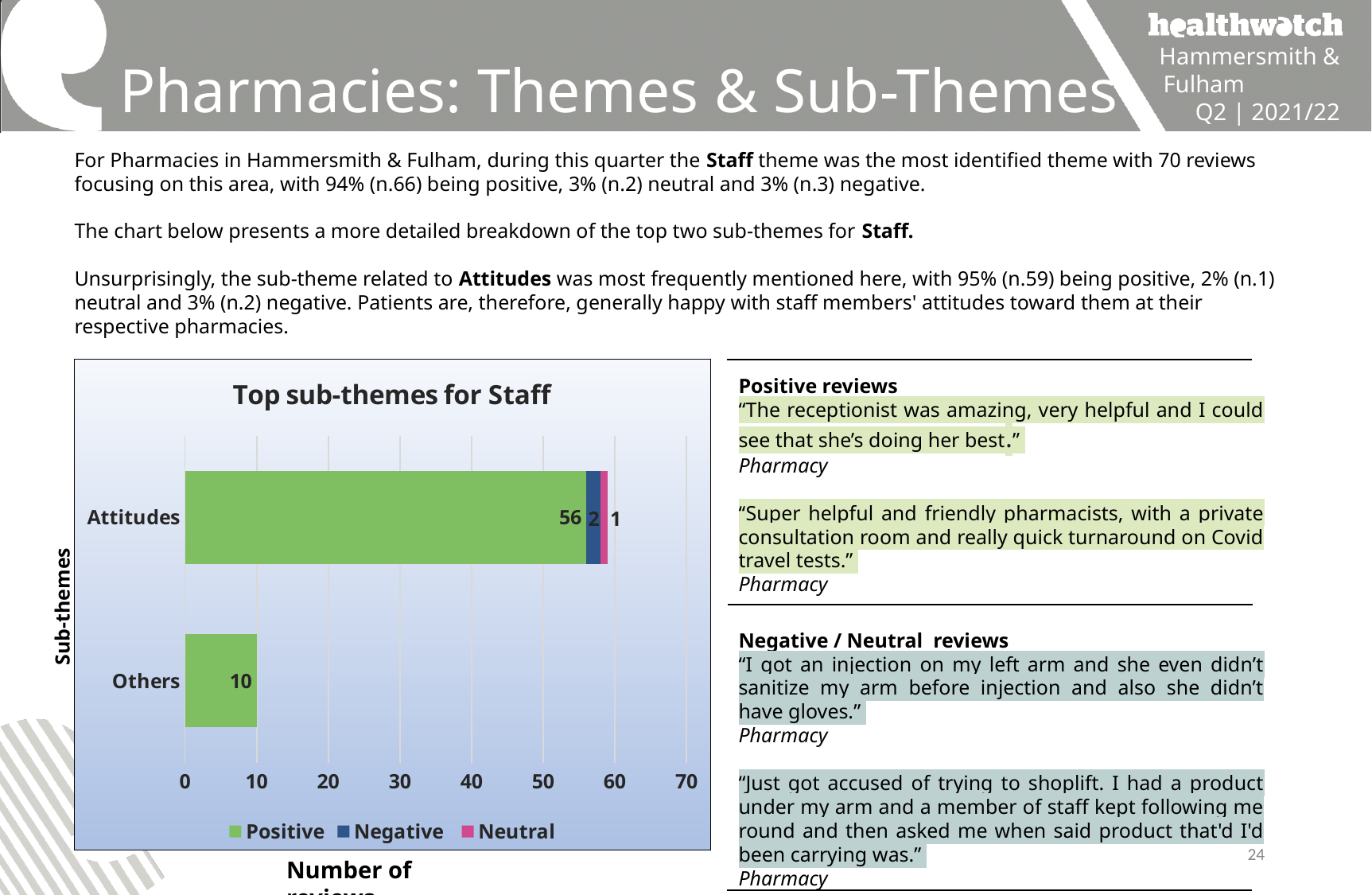
Which sub-theme has the highest number of Positive reviews? Attitudes What is the total of the stacked bar for Attitudes? 59 What is the Neutral value for Attitudes? 1 How many series does the chart legend list? 3 What is the Positive value for Others? 10 What is the difference between the Positive values for Attitudes and Others? 46 What is the Positive value for Attitudes? 56 What is the Negative value for Attitudes? 2 What type of chart is shown on the slide? Bar chart Is the Positive value for Attitudes greater or less than 50? greater How many sub-theme categories are plotted in the chart? 2 What is the title of the chart? Top sub-themes for Staff